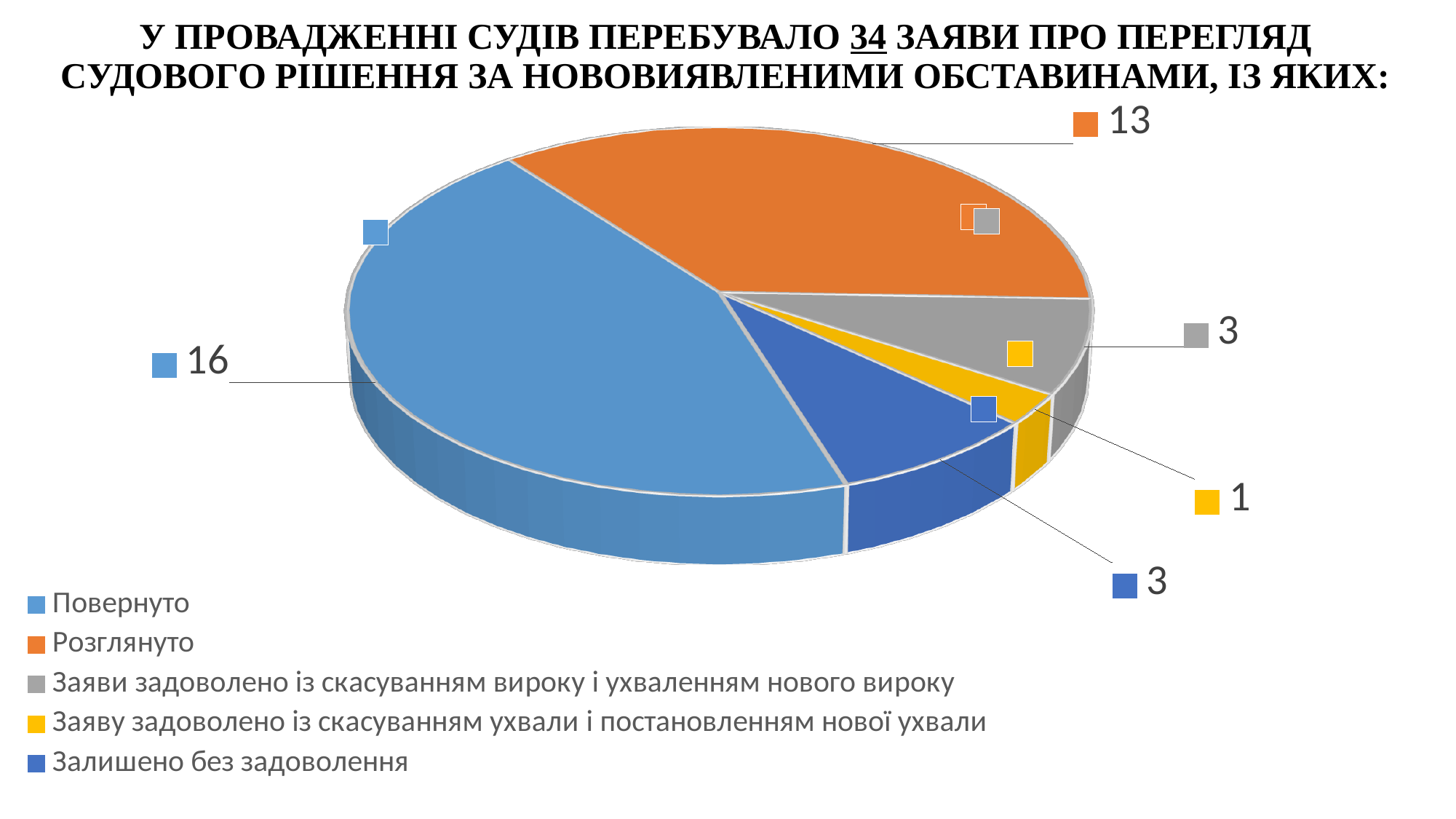
What is the difference between the values for Повернуто and Розглянуто? 3 What value is shown for Розглянуто? 13 Which category has the largest slice of the pie? Повернуто What value is shown for Залишено без задоволення? 3 What kind of chart is shown on the slide? Pie chart What colour is the slice for Розглянуто? Orange How many slices does the pie chart have? 5 Which category has the smallest slice of the pie? Заяву задоволено із скасуванням ухвали і постановленням нової ухвали What value is shown for Повернуто? 16 What value is shown for Заяви задоволено із скасуванням вироку і ухваленням нового вироку? 3 Which is larger, the value for Повернуто or the value for Розглянуто? Повернуто What value is shown for Заяву задоволено із скасуванням ухвали і постановленням нової ухвали? 1